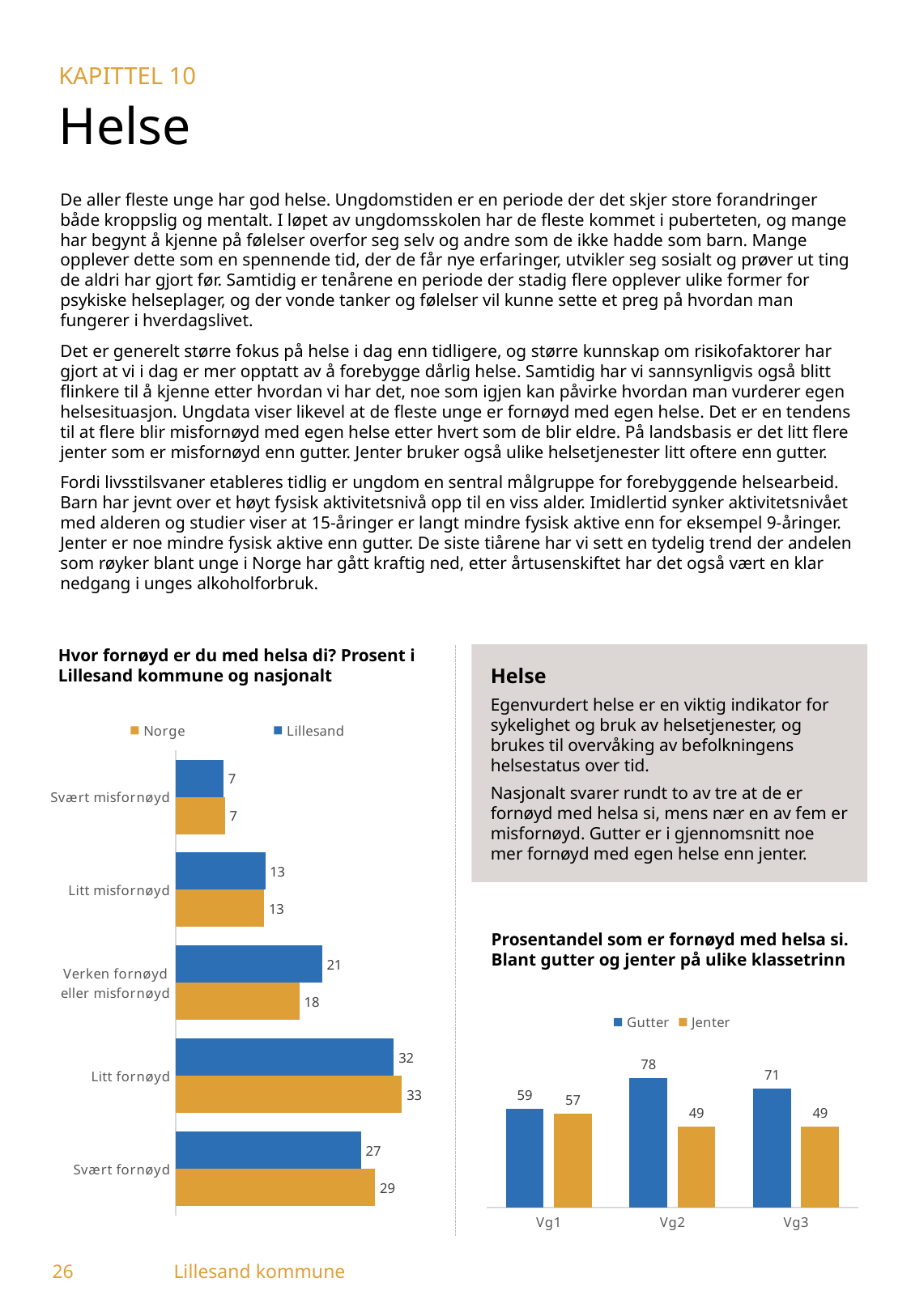
In the chart 'Prosentandel som er fornøyd med helsa si', which is larger at Vg1, Gutter or Jenter? Gutter In the chart 'Hvor fornøyd er du med helsa di?', what is the difference between Lillesand and Norge in the 'Verken fornøyd eller misfornøyd' category? 3 In the chart 'Prosentandel som er fornøyd med helsa si', what is the difference between Gutter and Jenter at Vg2? 29 In the chart 'Hvor fornøyd er du med helsa di?', what is the value for Norge in the 'Svært fornøyd' category? 29 In the chart 'Hvor fornøyd er du med helsa di?', which category has the highest value for Lillesand? Litt fornøyd In the chart 'Hvor fornøyd er du med helsa di?', how many categories are shown? 5 In the chart 'Hvor fornøyd er du med helsa di?', how many series does the legend list? 2 What kind of chart is 'Hvor fornøyd er du med helsa di?'? Bar chart In the chart 'Hvor fornøyd er du med helsa di?', what is the value for Lillesand in the 'Litt fornøyd' category? 32 In the chart 'Prosentandel som er fornøyd med helsa si', what is the value for Gutter at Vg2? 78 In the chart 'Prosentandel som er fornøyd med helsa si', what is the value for Jenter at Vg3? 49 In the chart 'Prosentandel som er fornøyd med helsa si', which colour represents Jenter? Orange